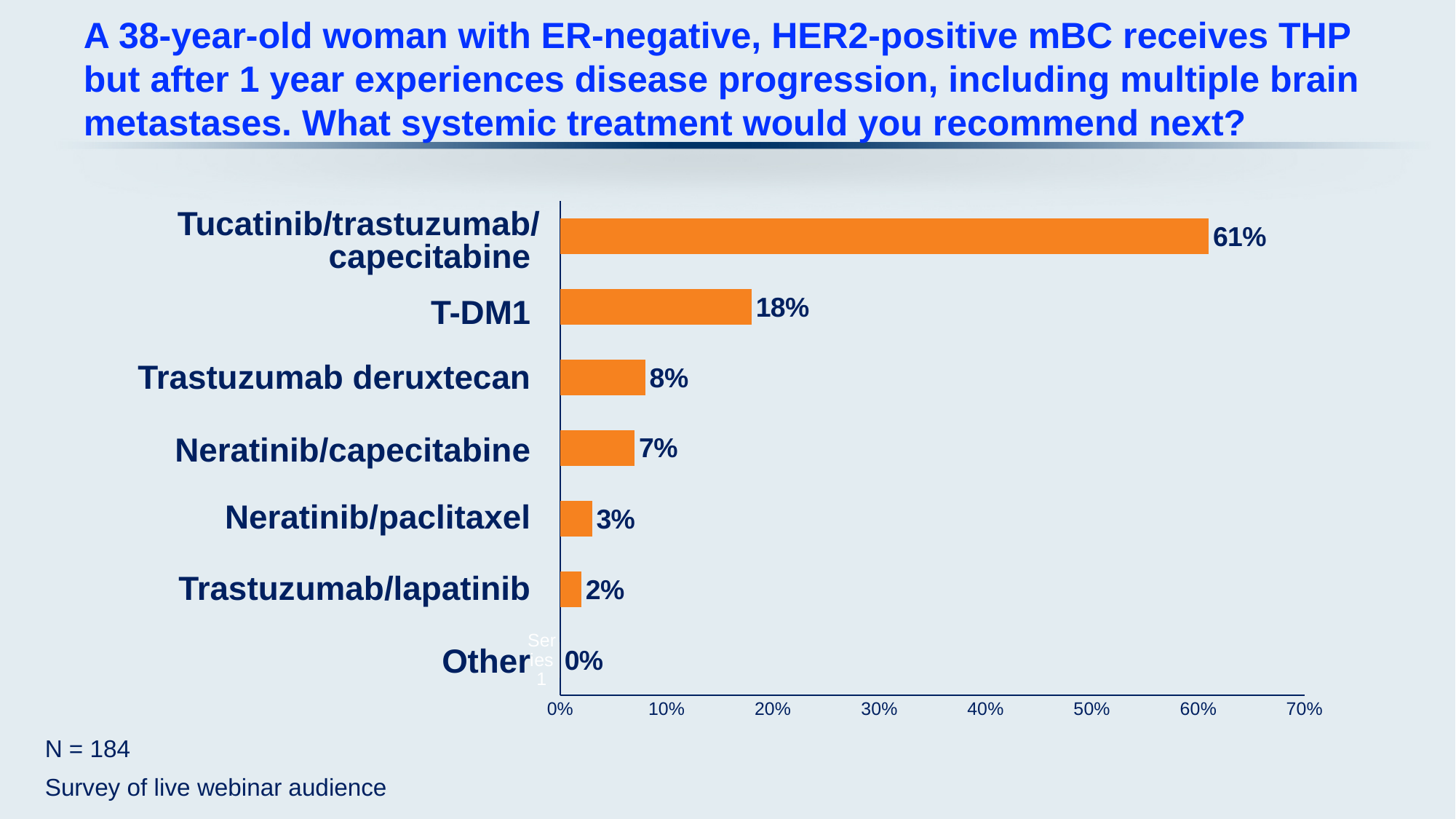
What kind of chart is shown on the slide? Bar chart How many treatment options are listed on the chart? 7 Which has a larger value, Trastuzumab deruxtecan or Neratinib/capecitabine? Trastuzumab deruxtecan What is the difference between the values for Neratinib/capecitabine and Trastuzumab/lapatinib? 5% What is the value shown for Trastuzumab deruxtecan? 8% What is the difference between the values for Tucatinib/trastuzumab/capecitabine and T-DM1? 43% What is the value shown for Neratinib/paclitaxel? 3% What percentage of respondents chose T-DM1? 18% What is the survey sample size (N) stated on the slide? 184 Which treatment option received the highest share of responses? Tucatinib/trastuzumab/capecitabine Which treatment option received the lowest share of responses? Other What percentage of respondents chose Tucatinib/trastuzumab/capecitabine? 61%